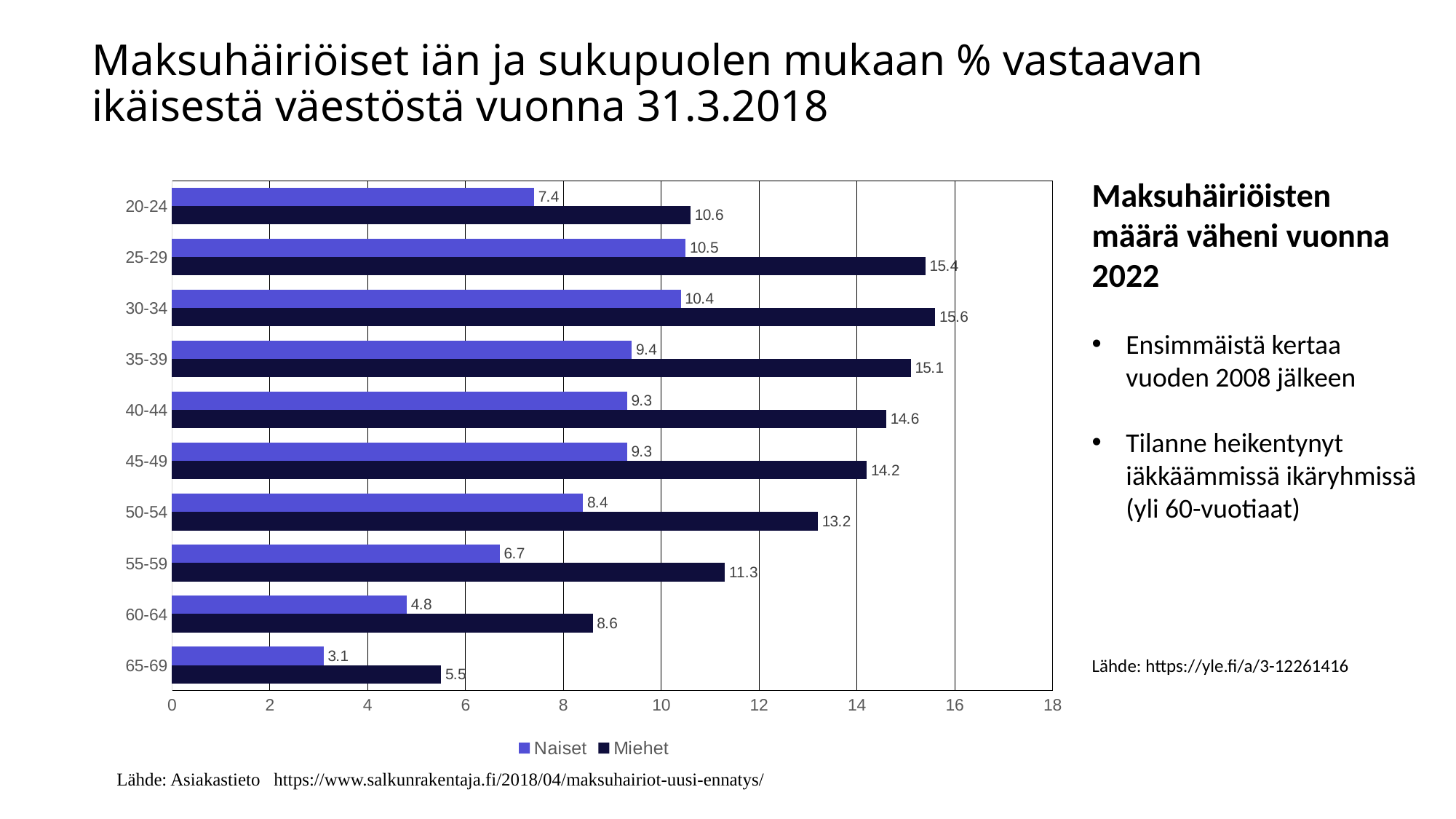
Which is larger in the 50-54 age group, the Naiset value or the Miehet value? Miehet Which series is shown in dark navy in the legend? Miehet What is the difference between the Miehet and Naiset values in the 25-29 age group? 4.9 What is the value for Naiset in the 20-24 age group? 7.4 Which age group has the highest value for Miehet? 30-34 How many series does the legend list? 2 How many age groups are shown on the chart? 10 Is the value for Miehet in the 55-59 age group greater or less than 10? greater What is the value for Miehet in the 65-69 age group? 5.5 Which age group has the lowest value for Naiset? 65-69 What is the value for Miehet in the 30-34 age group? 15.6 What kind of chart is shown on the slide? bar chart